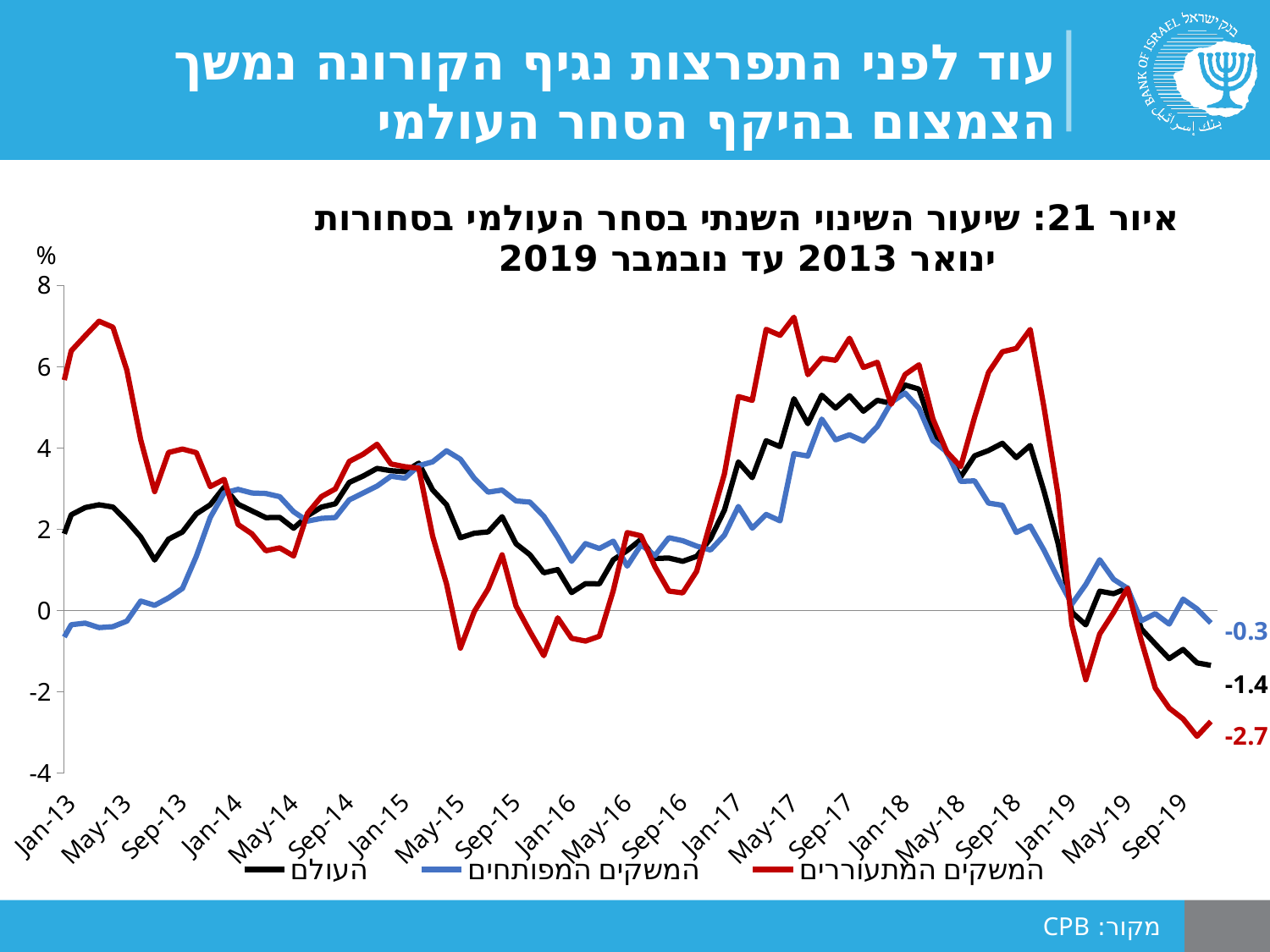
What is the difference between the final labelled values of the המשקים המפותחים series (-0.3) and the המשקים המתעוררים series (-2.7)? 2.4 What is the final labelled value for the המשקים המתעוררים (emerging economies) series at the end of the chart? -2.7 How many series does the legend list? 3 Which series has the highest labelled value at the end of the chart? המשקים המפותחים What type of chart is shown on the slide? line chart Which series has the lowest labelled value at the end of the chart? המשקים המתעוררים At the end of the chart, which is larger: the labelled value for העולם or for המשקים המתעוררים? העולם Is the value of the המשקים המפותחים (blue) series in Jan-13 greater or less than 0? less What is the final labelled value for the המשקים המפותחים (developed economies) series at the end of the chart? -0.3 What is the final labelled value for the העולם (world) series at the end of the chart? -1.4 Which colour is used for the העולם (world) series? black